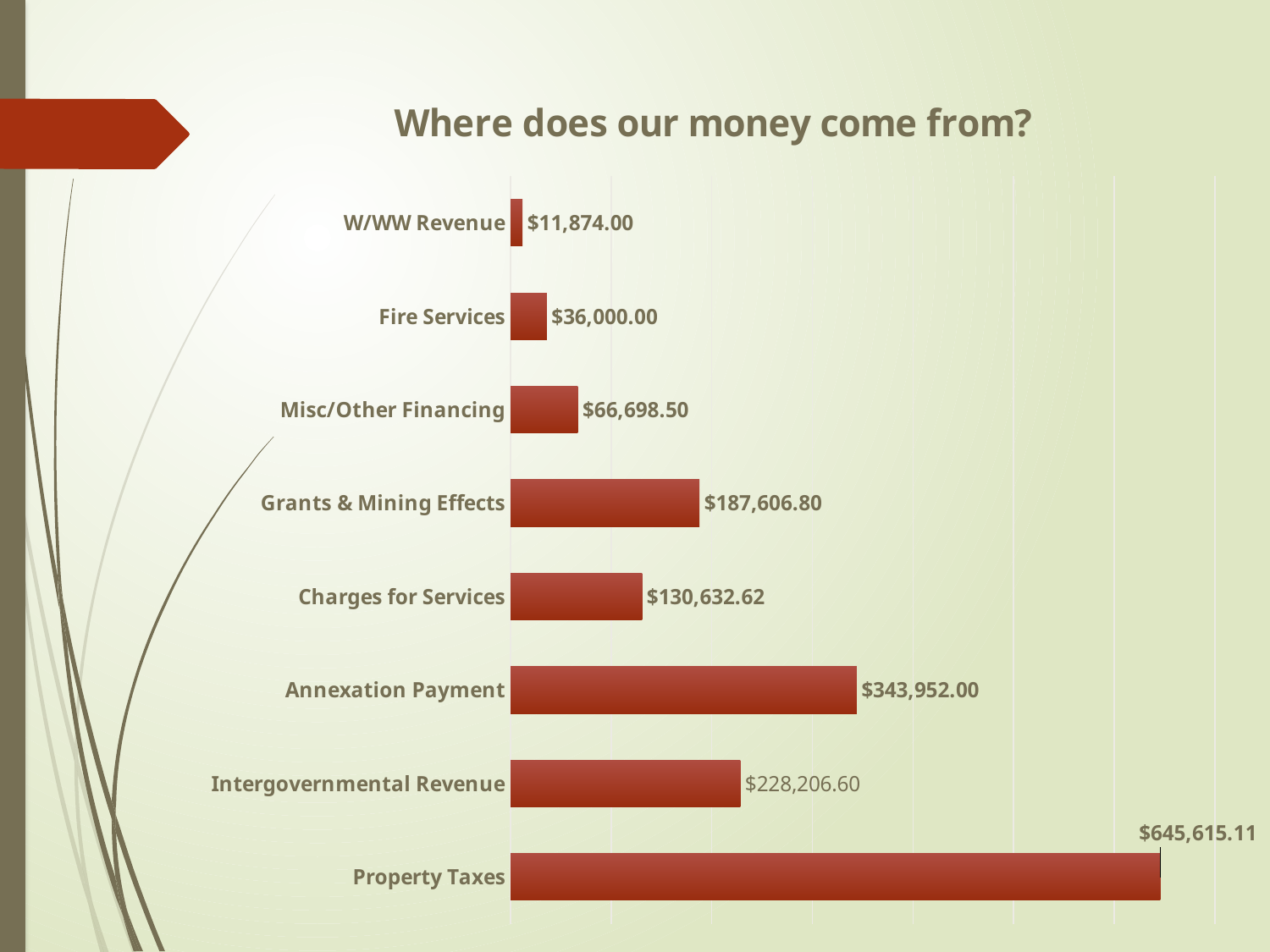
What is the value for Property Taxes? $645,615.11 What is the value for W/WW Revenue? $11,874.00 Which category has the lowest value? W/WW Revenue What is the value for Grants & Mining Effects? $187,606.80 Which category has the highest value? Property Taxes What is the difference between Fire Services and W/WW Revenue? $24,126.00 Which is larger, Grants & Mining Effects or Charges for Services? Grants & Mining Effects What is the value for Annexation Payment? $343,952.00 What is the value for Intergovernmental Revenue? $228,206.60 What kind of chart is shown on the slide? Bar chart What is the difference between Annexation Payment and Intergovernmental Revenue? $115,745.40 How many categories are shown in the chart? 8